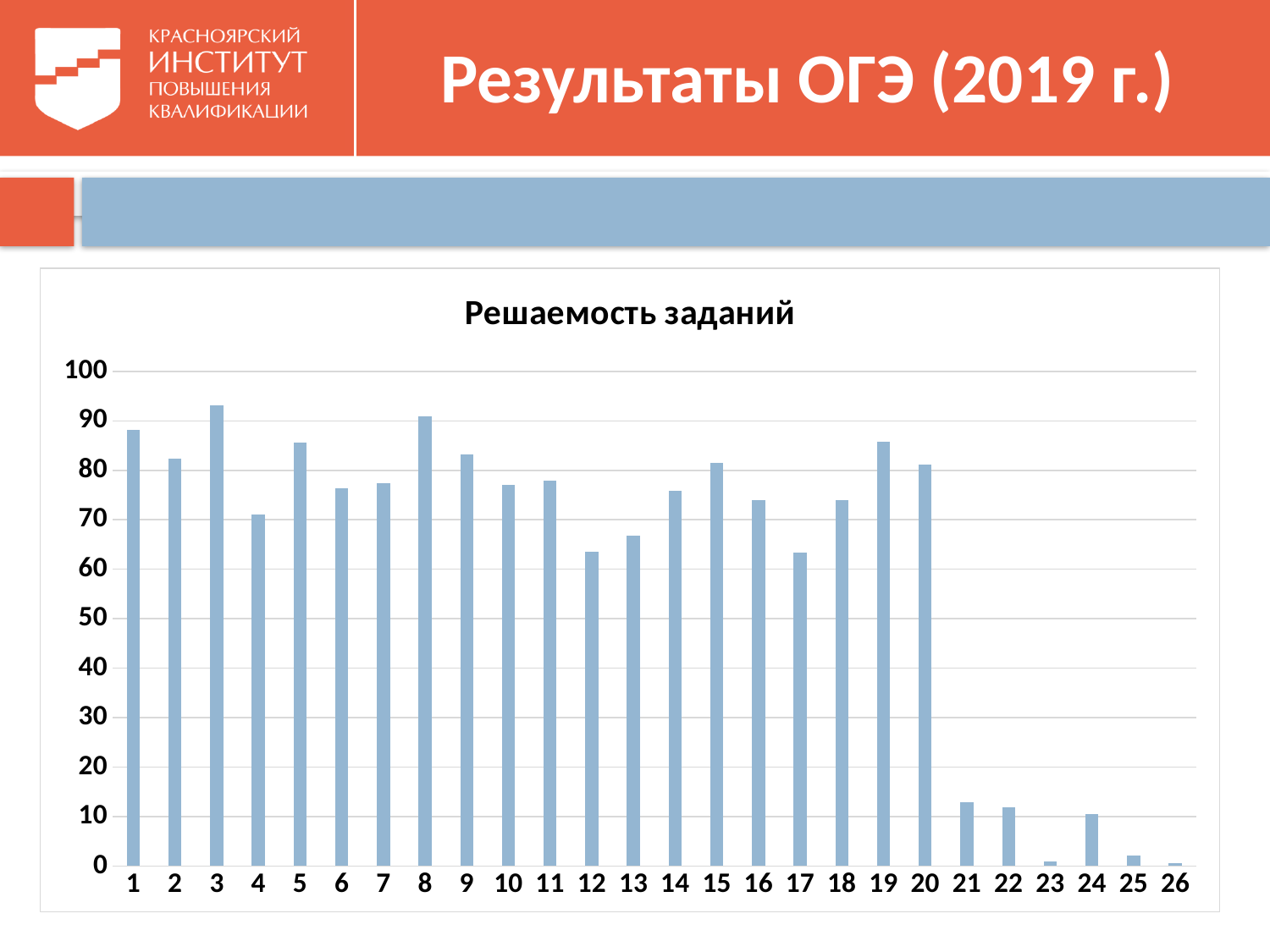
Which is larger, the value for task 12 or the value for task 13? task 13 Which task has the highest value in the chart? 3 Is the value for task 19 greater or less than 80? greater Is the value for task 12 greater or less than 70? less Is the value for task 1 greater or less than 80? greater Are the values for tasks 21 to 26 higher or lower than the values for tasks 1 to 20? lower How many categories (tasks) are shown on the x axis of the chart? 26 What kind of chart is shown on the slide? bar chart Which is larger, the value for task 20 or the value for task 21? task 20 Which is larger, the value for task 3 or the value for task 4? task 3 What is the title of the chart? Решаемость заданий